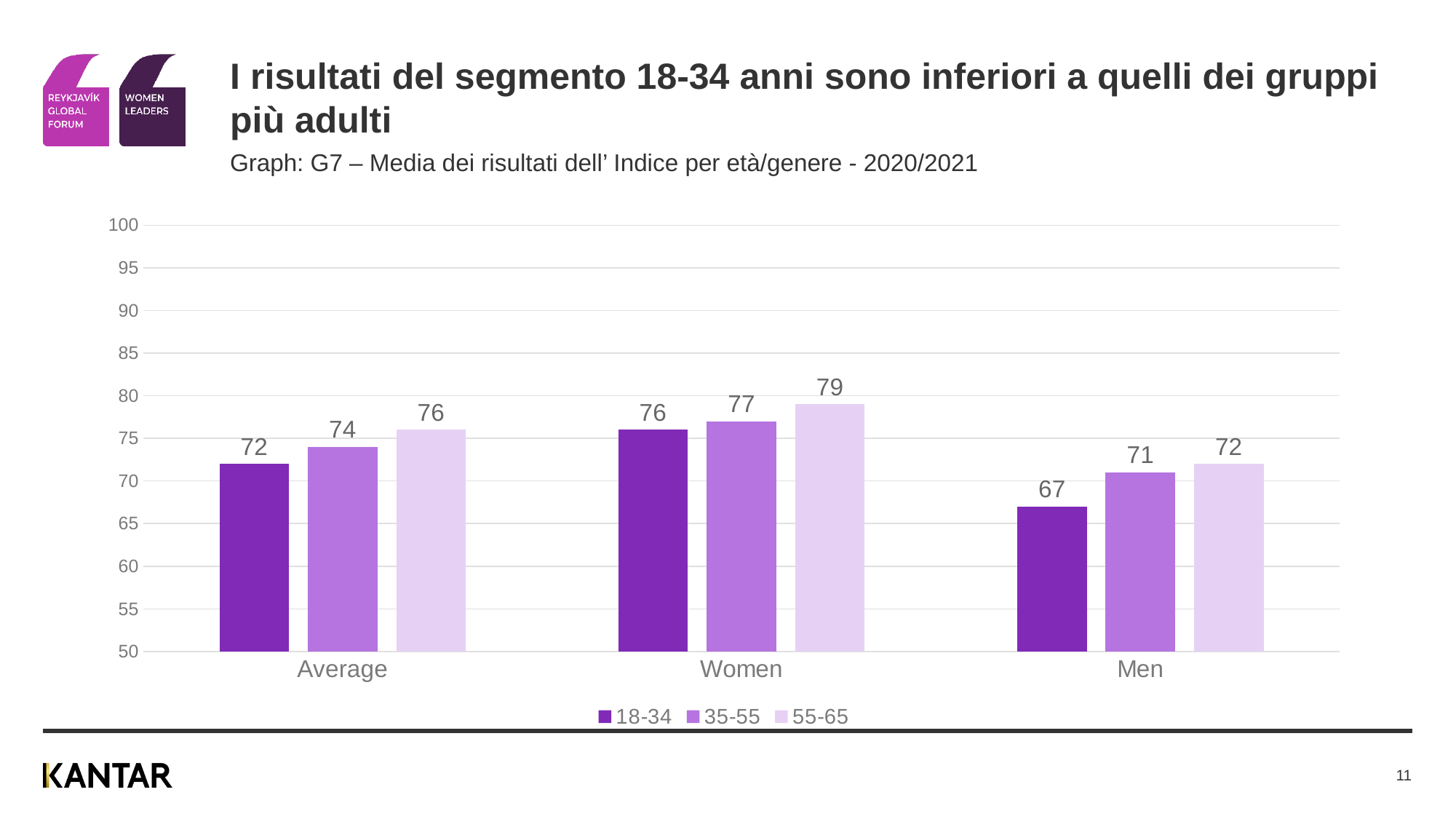
Which category has the highest value for the 18-34 series? Women What is the value for the 35-55 series in the Men category? 71 How many categories are shown on the x axis? 3 Is the value for 18-34 in the Men category greater or less than 70? less What is the subtitle of the graph shown on the slide? Graph: G7 – Media dei risultati dell' Indice per età/genere - 2020/2021 What is the value for the 18-34 series in the Average category? 72 Which category has the lowest value for the 55-65 series? Men What is the difference between the 55-65 and 18-34 values in the Men category? 5 How many series does the legend list? 3 What kind of chart is shown on the slide? bar chart Which is larger: the 35-55 value for Women or the 35-55 value for Men? Women What is the value for the 55-65 series in the Women category? 79